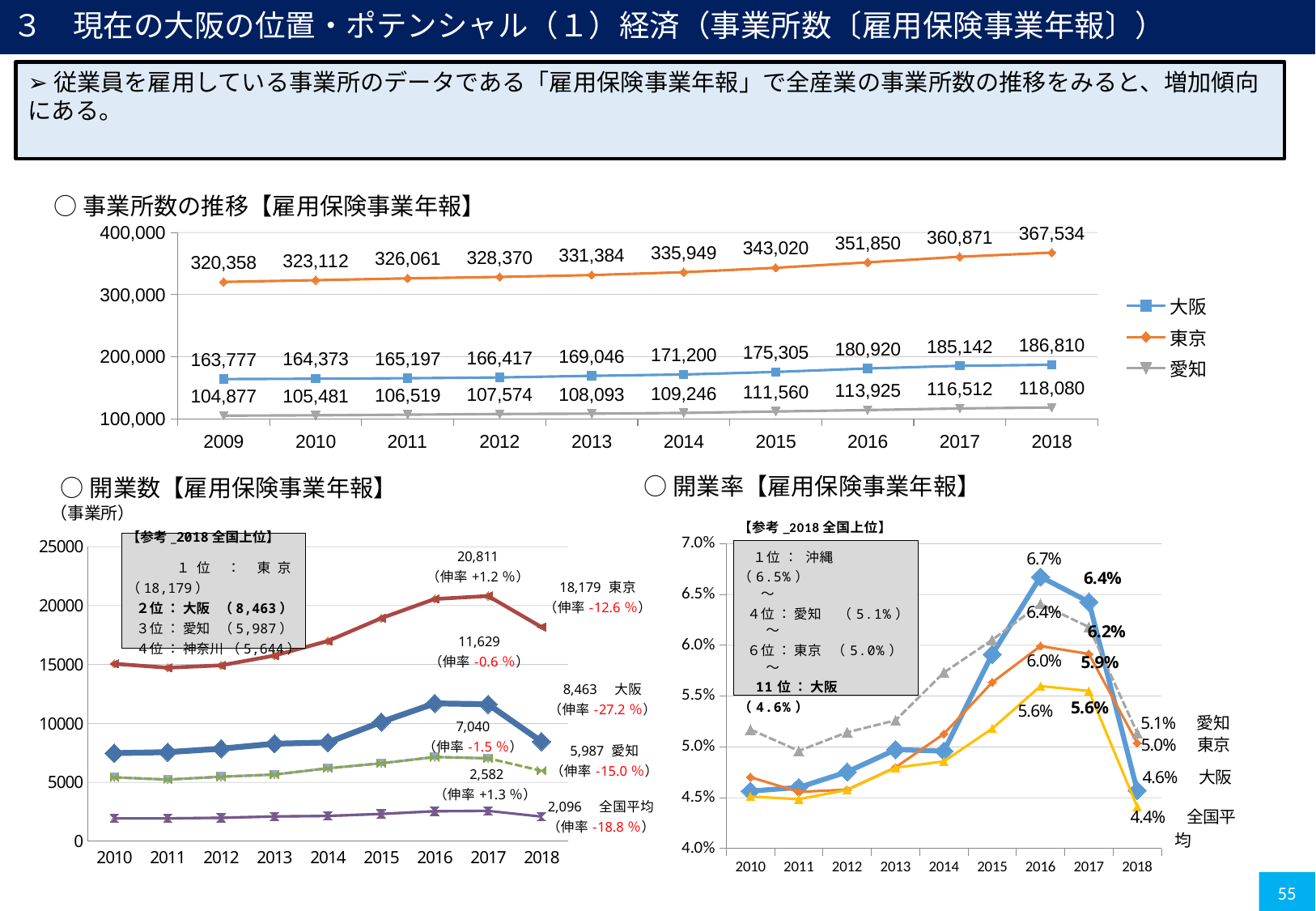
In the 事業所数の推移 chart at the top, by how much did the value for 大阪 increase from 2009 to 2018? 23,033 In the 開業率 chart at the bottom right, which series has the highest value in 2016? 大阪 In the 事業所数の推移 chart at the top, how many years are shown on the x axis? 10 In the 開業率 chart at the bottom right, what is the value for 大阪 in 2016? 6.7% In the 事業所数の推移 chart at the top, does the value for 東京 rise or fall from 2009 to 2018? rise In the 事業所数の推移 chart at the top, what is the value for 愛知 in 2015? 111,560 In the 事業所数の推移 chart at the top, how many series does the legend list? 3 What kind of chart is the 事業所数の推移 chart at the top? line chart In the 事業所数の推移 chart at the top, what is the value for 大阪 in 2009? 163,777 In the 事業所数の推移 chart at the top, what is the value for 東京 in 2018? 367,534 In the 開業数 chart at the bottom left, what is the value for 東京 in 2018? 18,179 In the 開業数 chart at the bottom left, what is the value for 大阪 in 2017? 11,629